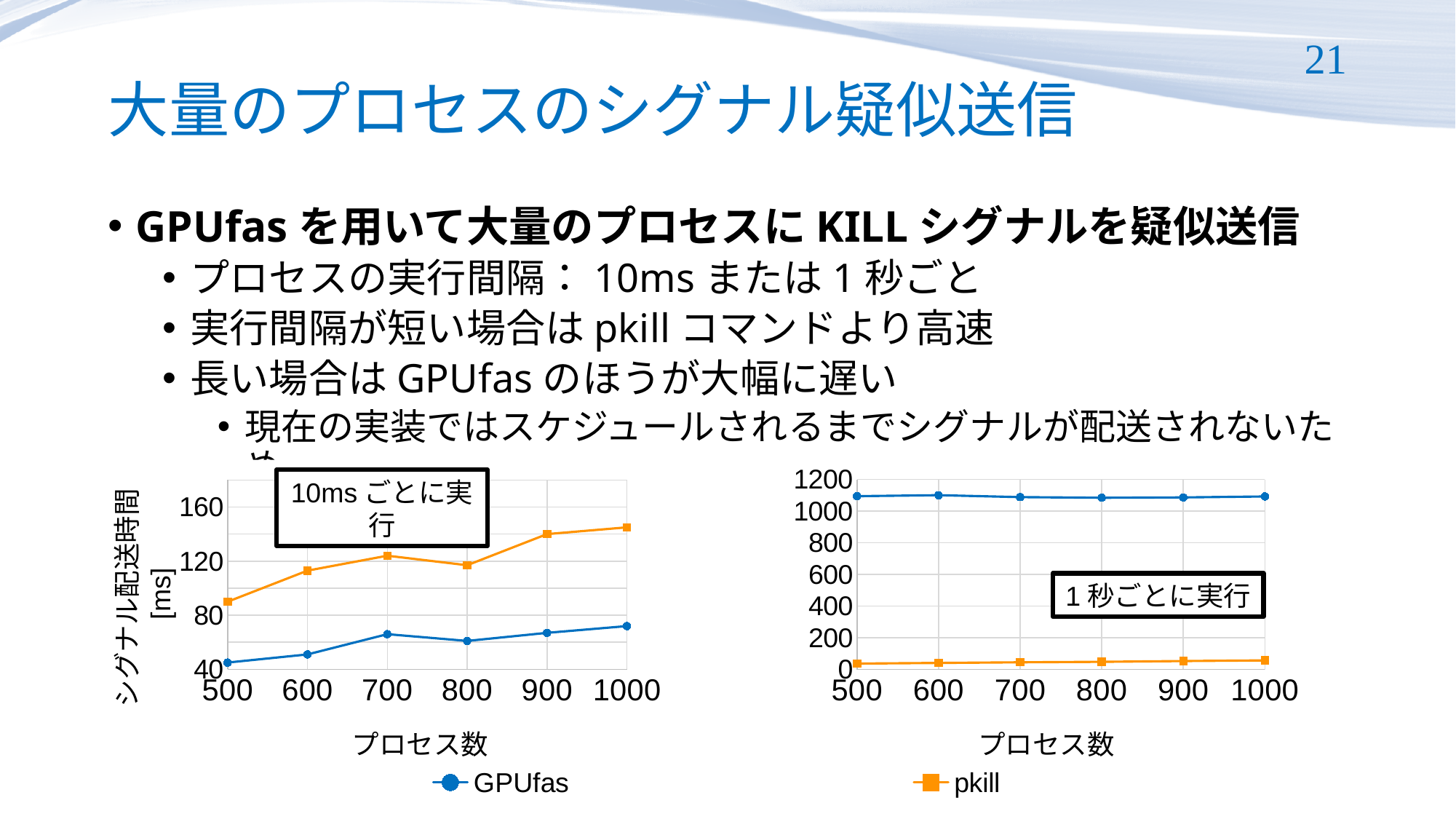
In the left chart (10ms ごとに実行), how many process-count points are plotted along the x axis? 6 In the left chart (10ms ごとに実行), which series has the larger value at 900 processes, GPUfas or pkill? pkill How many series does the legend list? 2 In the left chart (10ms ごとに実行), is the pkill value at 1000 processes greater or less than 120? greater In the right chart (1 秒ごとに実行), which series has the larger value at 800 processes, GPUfas or pkill? GPUfas In the left chart (10ms ごとに実行), is the pkill value at 500 processes greater or less than 80? greater In the right chart (1 秒ごとに実行), is the GPUfas value at 500 processes greater or less than 1000? greater What is the label of the y axis shown next to the left chart? シグナル配送時間 [ms] What kind of chart is the left chart labelled 10ms ごとに実行? line chart In the left chart (10ms ごとに実行), does the pkill line generally rise or fall as the number of processes increases from 500 to 1000? rise